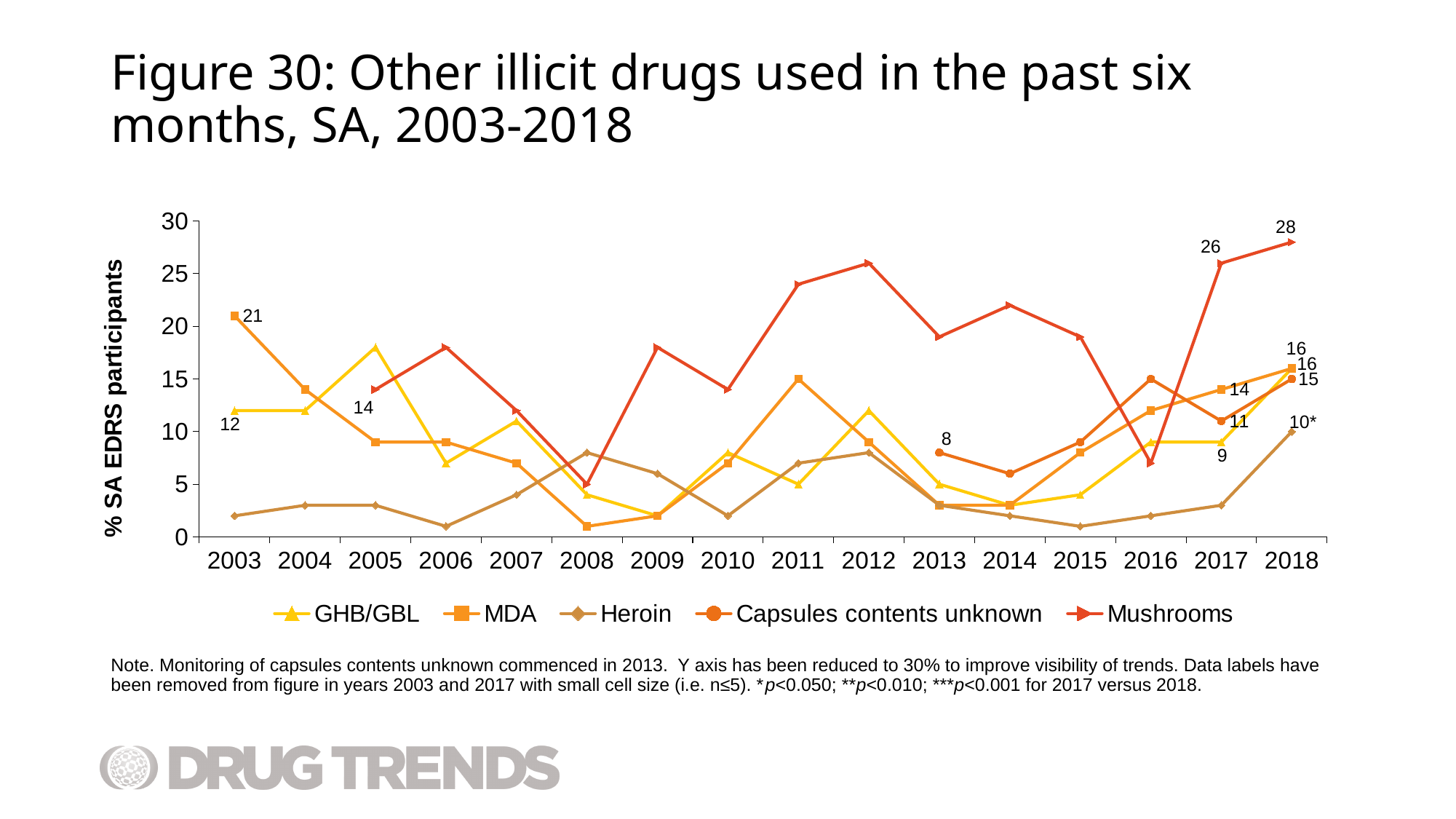
Which series has the highest value in 2018? Mushrooms How many series does the legend list? 5 By how much did the Mushrooms value increase from 2017 to 2018? 2 What is the value for GHB/GBL in 2017? 9 In 2003, which is larger: the value for MDA or the value for GHB/GBL? MDA What kind of chart is shown on the slide? line chart What is the value for MDA in 2003? 21 What is the value for Mushrooms in 2018? 28 What is the label on the y axis? % SA EDRS participants Is the value for Mushrooms in 2012 greater or less than 20? greater What is the value for Capsules contents unknown in 2013? 8 What is the data label for Heroin in 2018? 10*